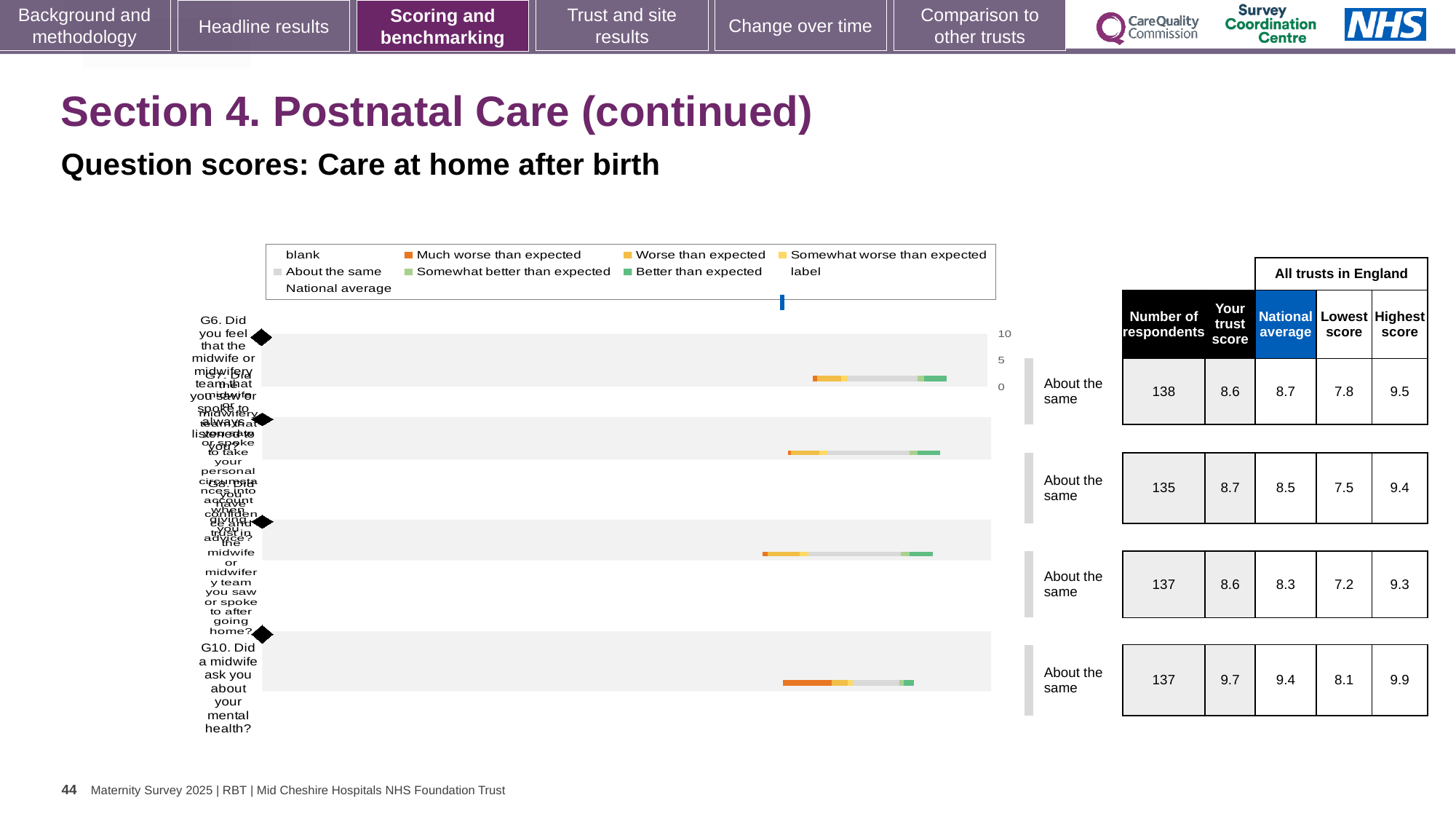
What is the national average for G6 (midwife or midwifery team listened to you)? 8.7 What is the benchmark result shown for G6 (midwife or midwifery team listened to you)? About the same In the chart legend, what colour represents 'Much worse than expected'? orange What kind of chart is shown on the slide? bar chart For G7, which is larger: the trust score or the national average? the trust score How many questions (categories) are plotted in the chart? 4 What is the difference between the highest score and the lowest score for G10? 1.8 What is the number of respondents for G10 (Did a midwife ask you about your mental health)? 137 In the chart legend, what colour represents 'Better than expected'? green Which question has the highest trust score? G10 What is the lowest score among all trusts in England for G8? 7.2 What is the trust score for G10 (Did a midwife ask you about your mental health)? 9.7